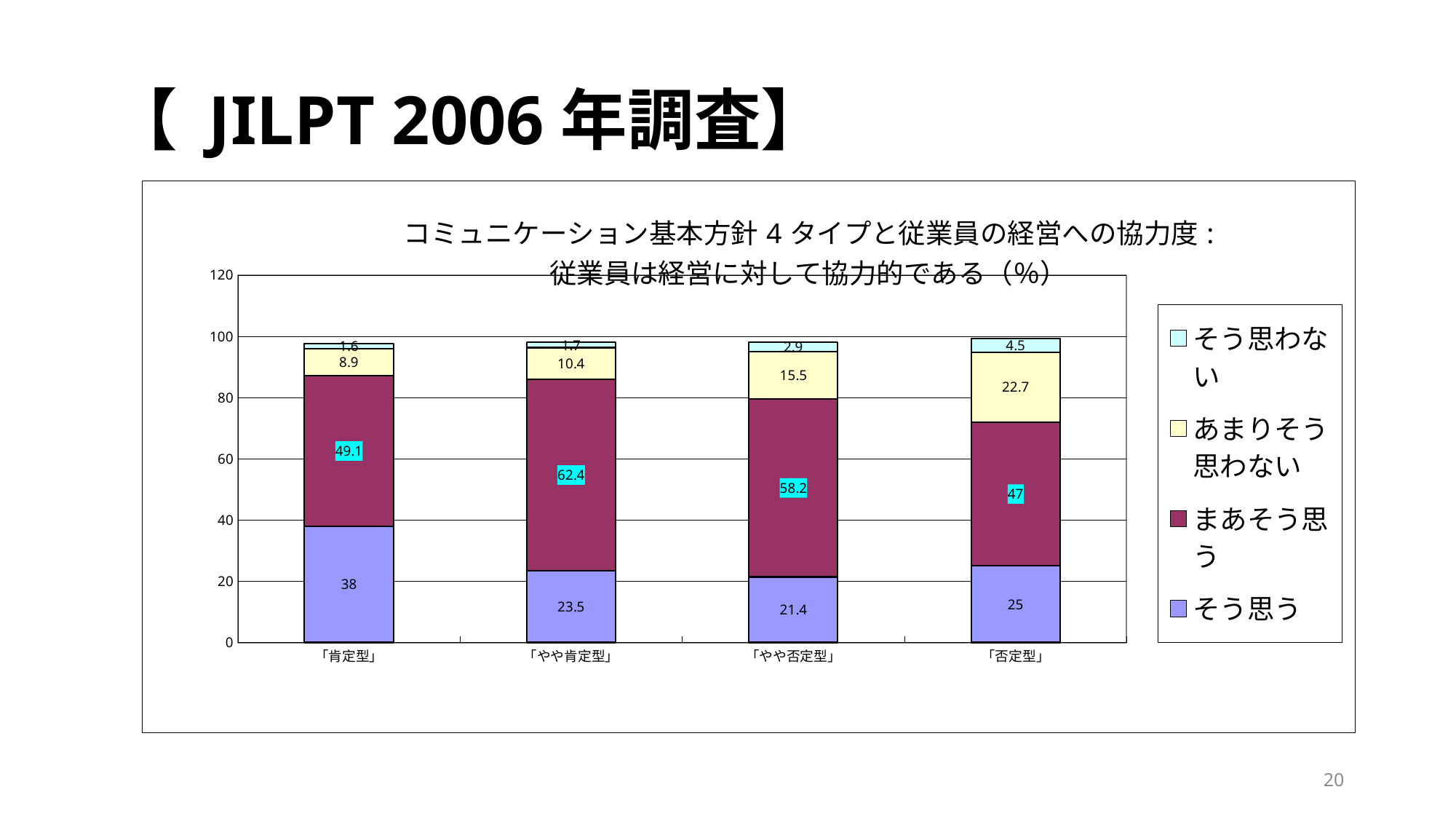
What is the value of そう思う for 「肯定型」? 38 Which category has the lowest value for あまりそう思わない? 「肯定型」 What is the total of the stacked bar for 「否定型」? 99.2 How many categories are shown on the x axis? 4 What is the difference between the そう思う values for 「肯定型」 and 「やや否定型」? 16.6 How many series does the legend list? 4 Which category has the highest value for そう思う? 「肯定型」 What kind of chart is shown on the slide? stacked bar chart What is the value of まあそう思う for 「やや肯定型」? 62.4 Which is larger: the まあそう思う value for 「やや否定型」 or for 「否定型」? 「やや否定型」 What is the value of あまりそう思わない for 「否定型」? 22.7 What is the value of そう思わない for 「やや否定型」? 2.9